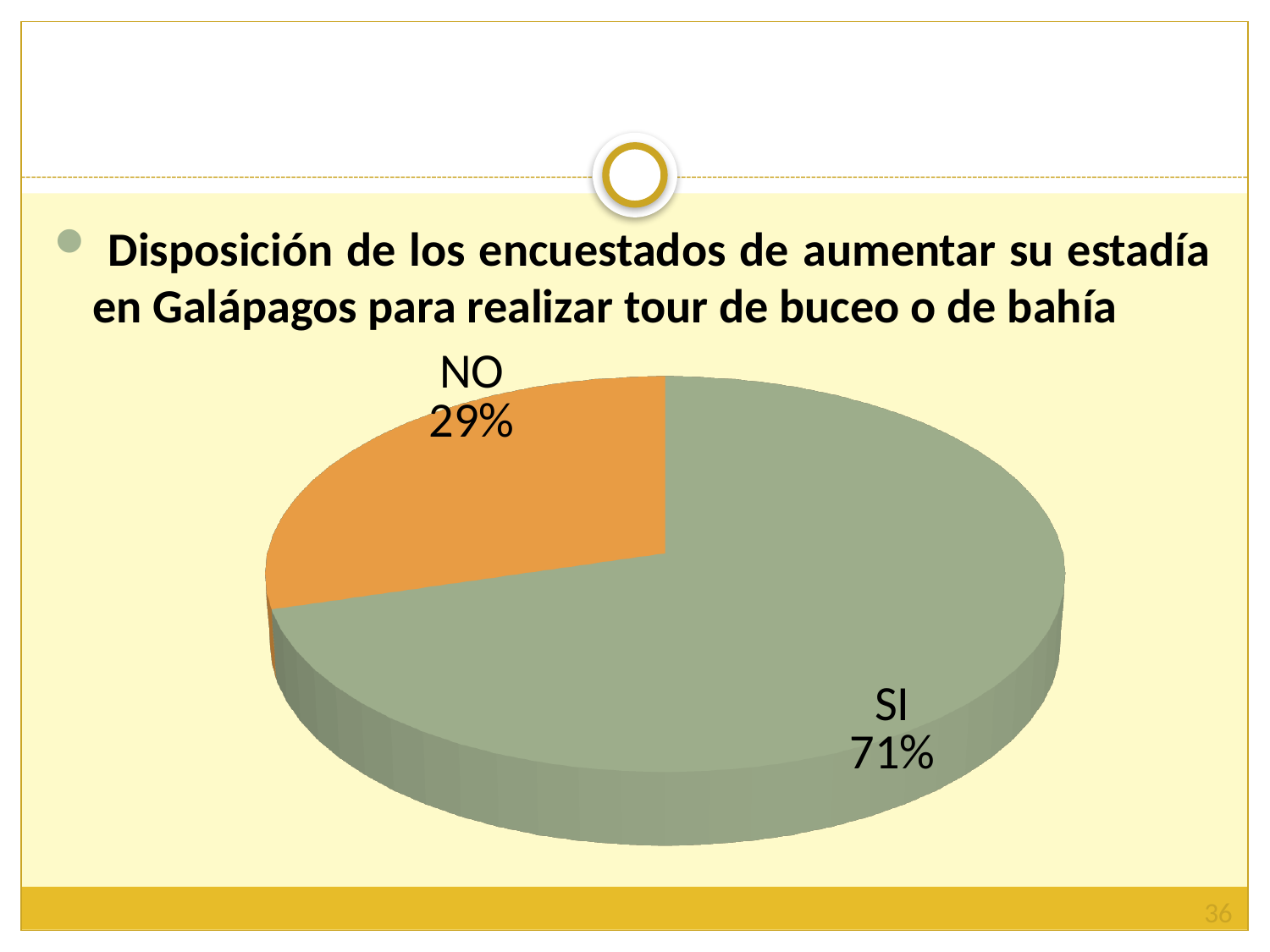
What kind of chart is shown on the slide? pie chart What share of the pie does the SI slice represent? 71% What percentage of respondents answered NO? 29% Which response has the smallest share of the pie? NO What percentage of respondents answered SI? 71% Which slice is larger, SI or NO? SI Which response has the largest share of the pie? SI What colour is the NO slice? orange What colour is the SI slice? green What is the difference in percentage points between the SI and NO slices? 42 How many slices does the pie chart have? 2